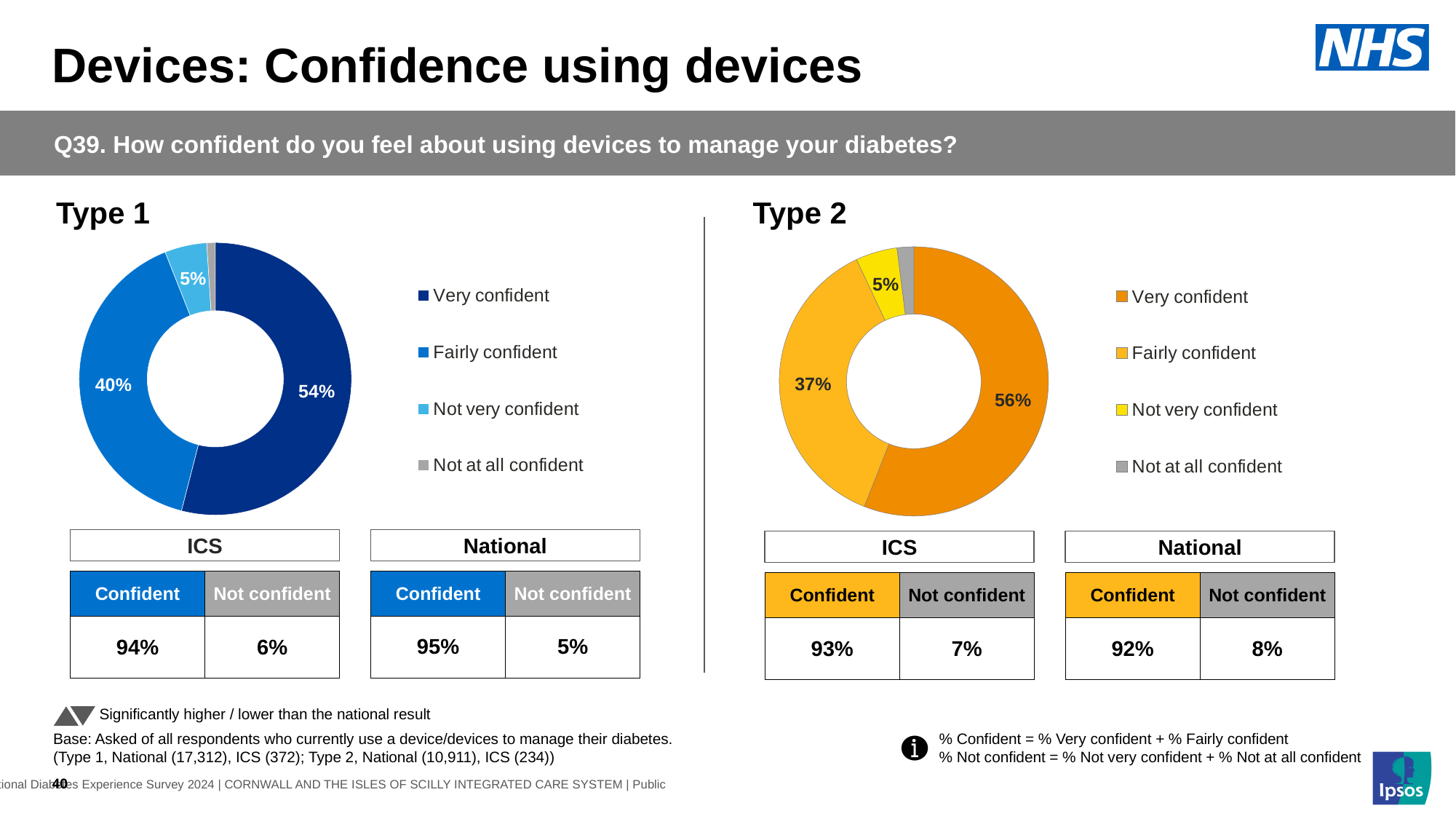
In the Type 2 chart, what colour represents Not very confident? Yellow Which is larger: the Very confident share in the Type 1 chart or the Very confident share in the Type 2 chart? Type 2 What kind of chart is used for Type 1? Donut (pie) chart In the Type 1 chart, what percentage of respondents are very confident? 54% In the Type 1 chart, what is the difference between the Very confident and Fairly confident shares? 14 percentage points In the Type 2 chart, what percentage of respondents are fairly confident? 37% In the Type 1 chart, what percentage of respondents are not very confident? 5% How many categories does the Type 1 chart show? 4 In the Type 1 chart, which category has the smallest share? Not at all confident In the Type 2 chart, which category has the largest share? Very confident In the Type 2 chart, what is the difference between the Very confident and Fairly confident shares? 19 percentage points How many entries does the legend of the Type 2 chart list? 4